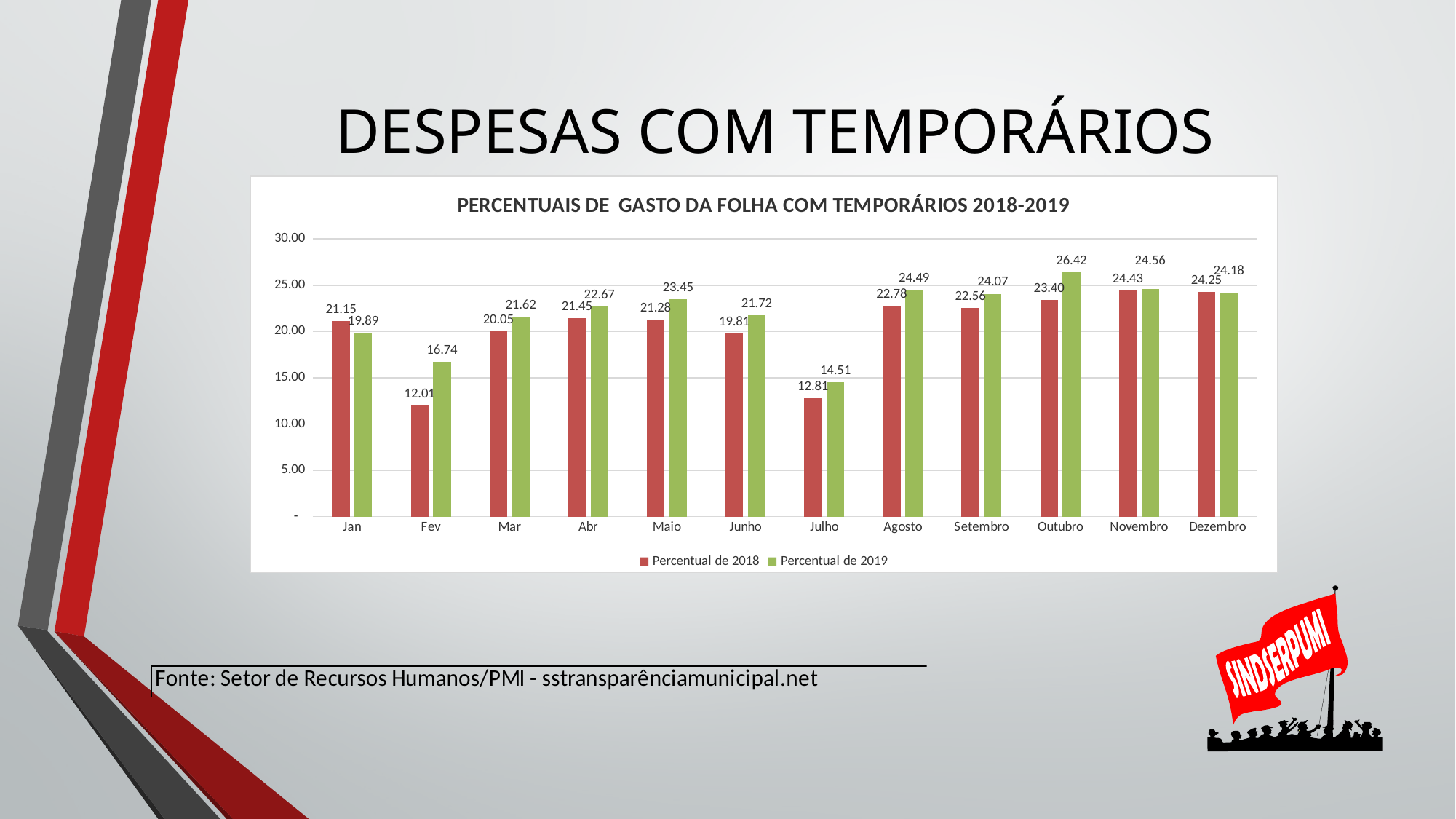
Which month has the highest Percentual de 2018 value? Novembro How many months are shown on the x axis? 12 Is the Percentual de 2018 value for Julho greater or less than 15.00? less What is the difference between the Percentual de 2019 and Percentual de 2018 values for Fev? 4.73 How many series does the legend list? 2 What is the Percentual de 2019 value for Julho? 14.51 Which month has the lowest Percentual de 2018 value? Fev What kind of chart is shown on the slide? bar chart Which is larger for Jan: Percentual de 2018 or Percentual de 2019? Percentual de 2018 What is the Percentual de 2019 value for Outubro? 26.42 Which month has the highest Percentual de 2019 value? Outubro What is the Percentual de 2018 value for Fev? 12.01